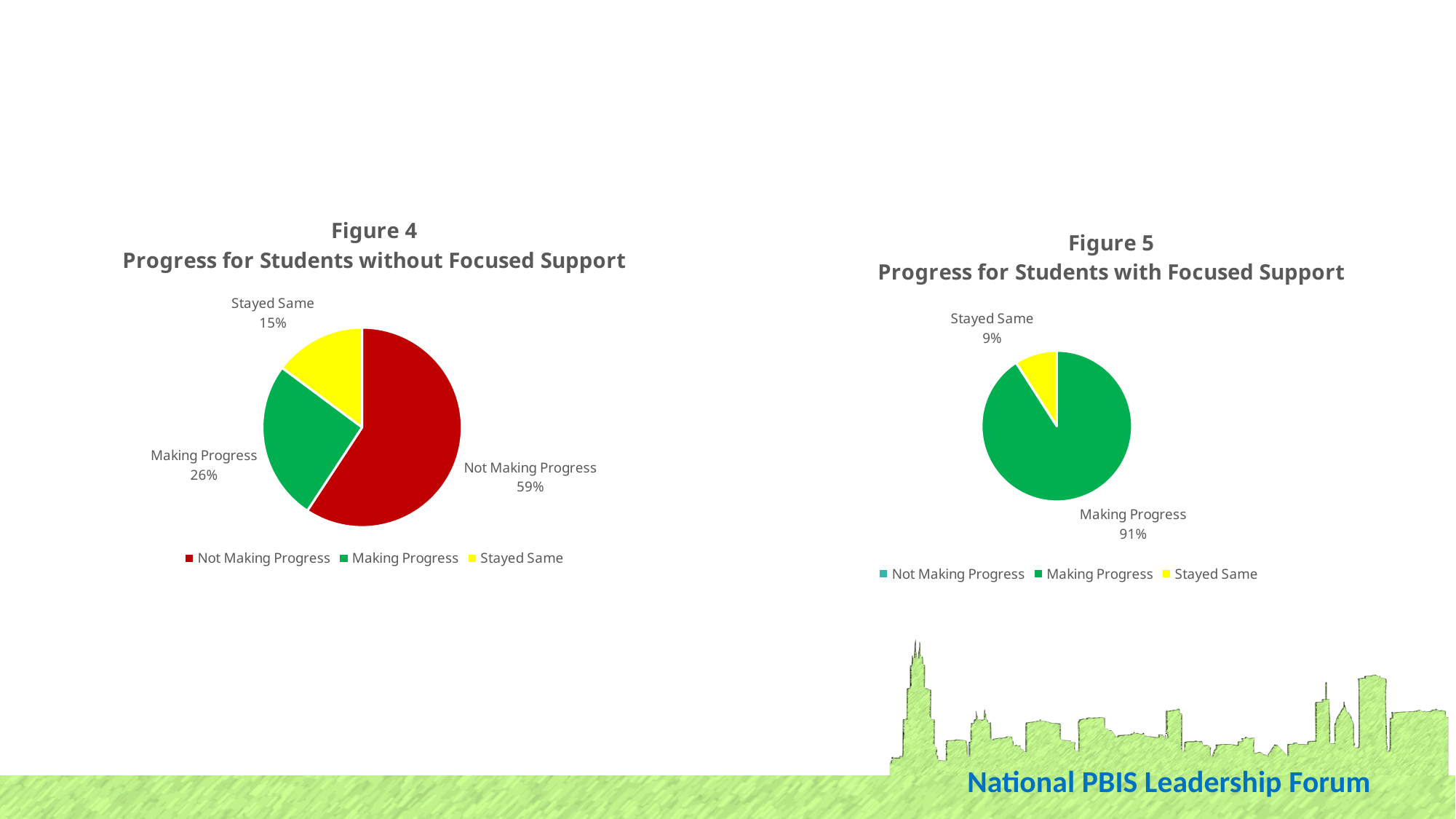
In the Figure 5 chart, what is the difference in percentage points between Making Progress and Stayed Same? 82 In the Figure 5 chart, what percentage of students Stayed Same? 9% Which is larger: the Making Progress share in Figure 4 or the Making Progress share in Figure 5? Figure 5 In the Figure 4 chart, which category has the largest slice? Not Making Progress In the Figure 4 chart, which category has the smallest slice? Stayed Same In the Figure 4 chart, what percentage of students are Making Progress? 26% In the Figure 4 chart, what is the difference in percentage points between Not Making Progress and Making Progress? 33 In the Figure 4 chart (Progress for Students without Focused Support), what share of students are Not Making Progress? 59% How many entries does the legend of the Figure 4 chart list? 3 In the Figure 5 chart (Progress for Students with Focused Support), what percentage of students are Making Progress? 91% What type of chart is used in Figure 5? Pie chart In the Figure 4 chart, what percentage of students Stayed Same? 15%